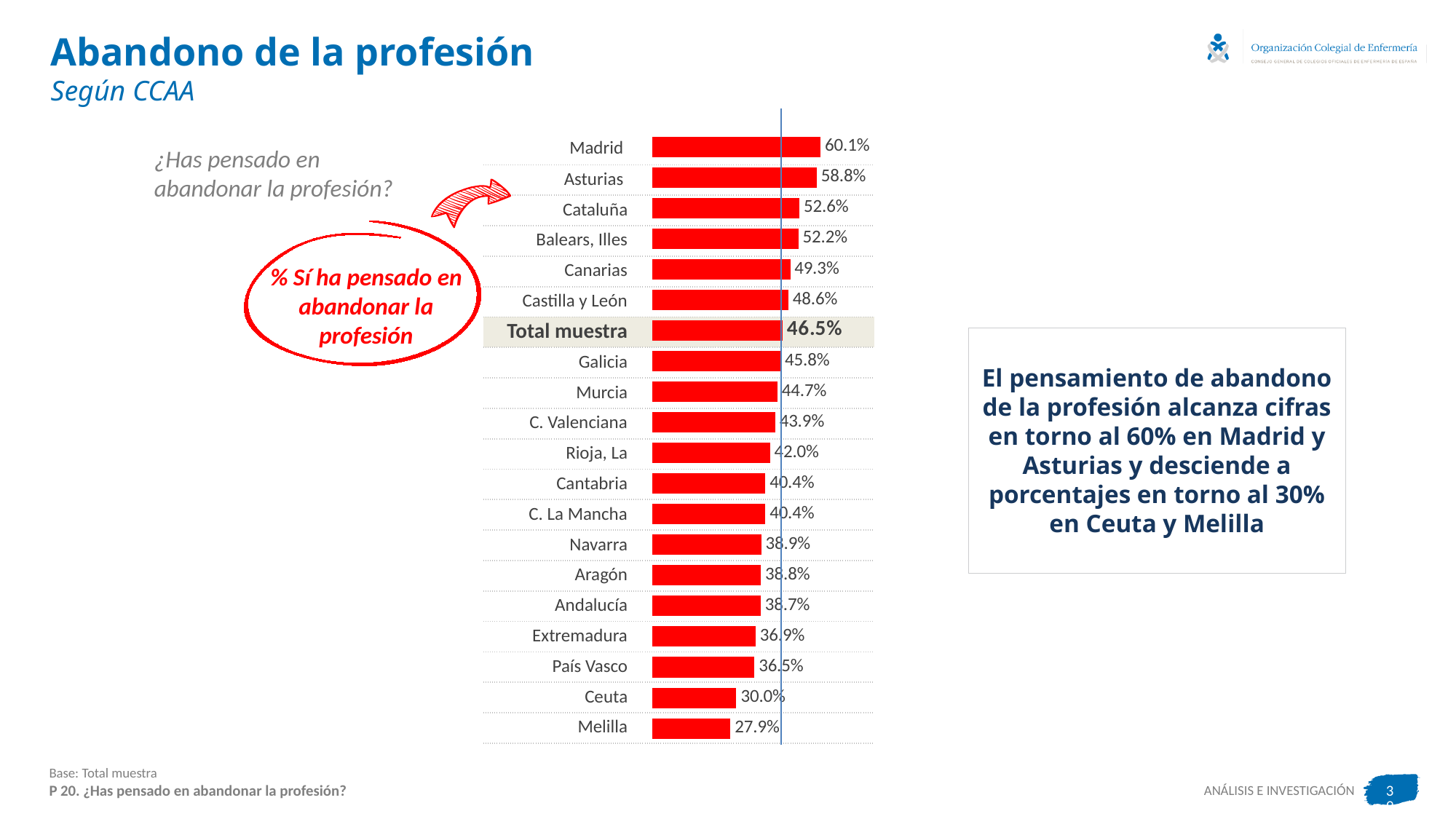
What is the value shown for País Vasco? 36.5% How many bars (categories) are shown in the chart? 20 What percentage of respondents in Madrid have thought about leaving the profession? 60.1% What is the difference between the values for Madrid and Melilla? 32.2 percentage points What type of chart is shown on the slide? Bar chart Which region has the lowest percentage in the chart? Melilla Which has a higher value, Canarias or Castilla y León? Canarias What is the value shown for Total muestra? 46.5% What is the value shown for Galicia? 45.8% What is the difference between the values for Asturias and Cataluña? 6.2 percentage points Which region has the highest percentage in the chart? Madrid What colour are the bars in the chart? Red